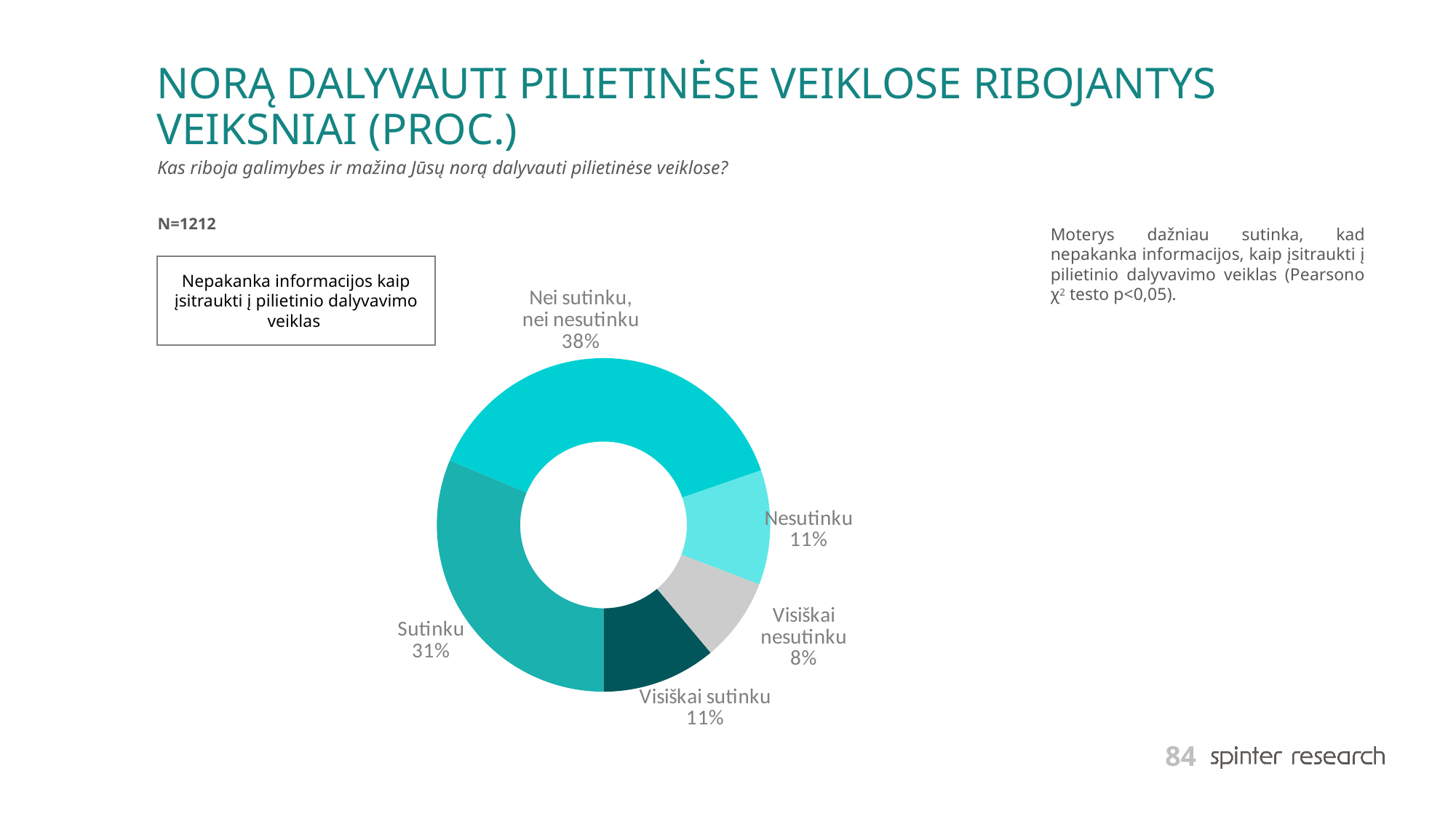
Which response category has the smallest share of the chart? Visiškai nesutinku What is the difference in percentage points between "Nei sutinku, nei nesutinku" and "Sutinku"? 7 What kind of chart is shown on the slide? Donut (pie) chart How many response categories are shown in the chart? 5 What is the combined share of "Sutinku" and "Visiškai sutinku"? 42% What percentage of respondents answered "Nei sutinku, nei nesutinku"? 38% Which response category has the largest share of the chart? Nei sutinku, nei nesutinku What percentage of respondents answered "Visiškai sutinku"? 11% What percentage of respondents answered "Sutinku"? 31% Which is larger: the share for "Sutinku" or the share for "Nesutinku"? Sutinku What is the sample size (N) stated on the slide? N=1212 What percentage of respondents answered "Visiškai nesutinku"? 8%